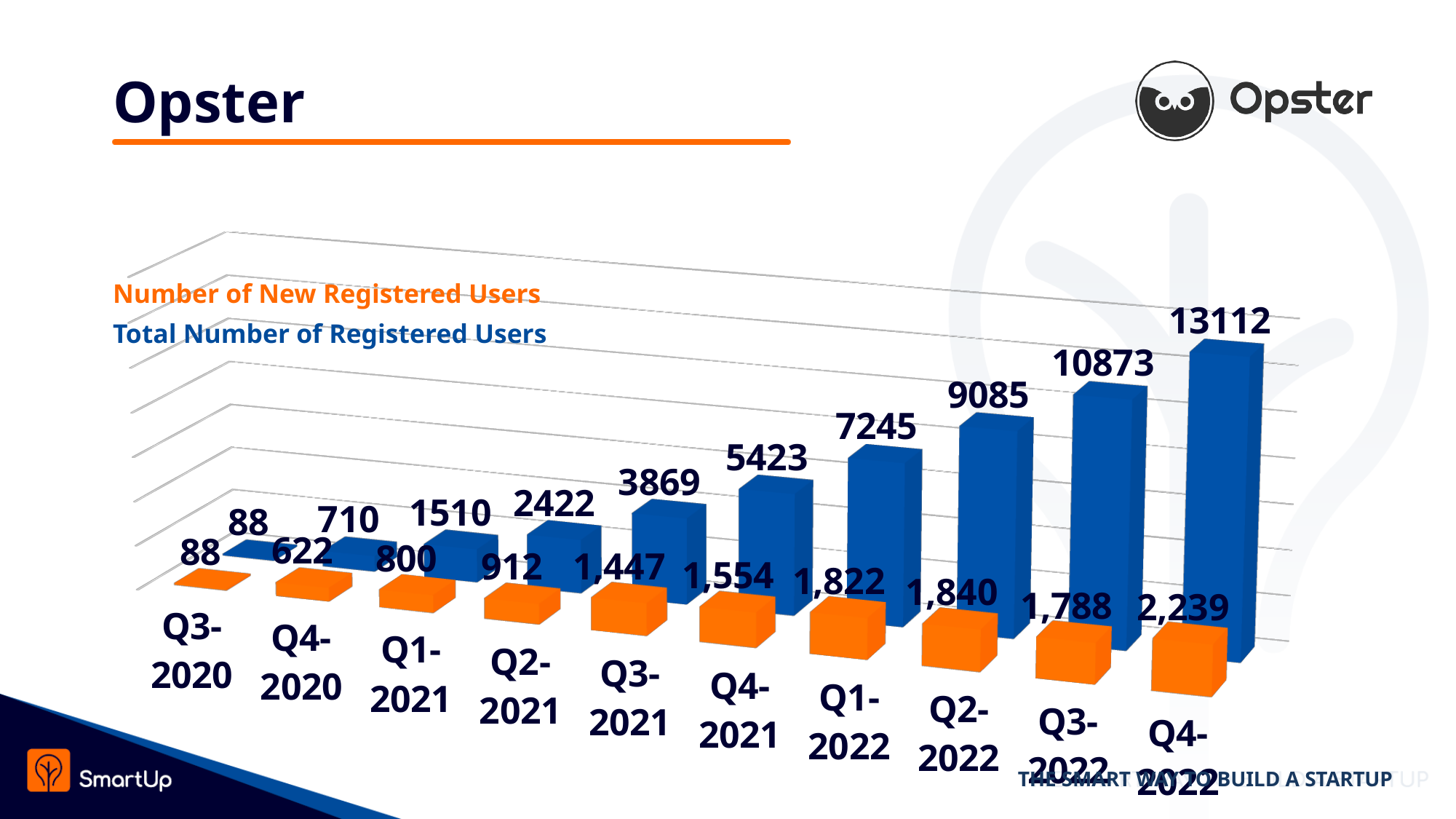
What is the Number of New Registered Users in Q3-2021? 1,447 Which quarter has the highest Number of New Registered Users? Q4-2022 What is the difference between the Total Number of Registered Users in Q4-2022 and Q3-2022? 2239 What is the Total Number of Registered Users in Q2-2021? 2422 How many quarters are shown on the chart? 10 How many series does the chart show? 2 What is the Number of New Registered Users in Q4-2020? 622 Does the Total Number of Registered Users rise or fall from Q3-2020 to Q4-2022? Rise What is the Total Number of Registered Users in Q4-2022? 13112 What kind of chart is shown on the slide? Bar chart Which quarter has the lowest Total Number of Registered Users? Q3-2020 Which is larger: the Number of New Registered Users in Q2-2022 or in Q3-2022? Q2-2022